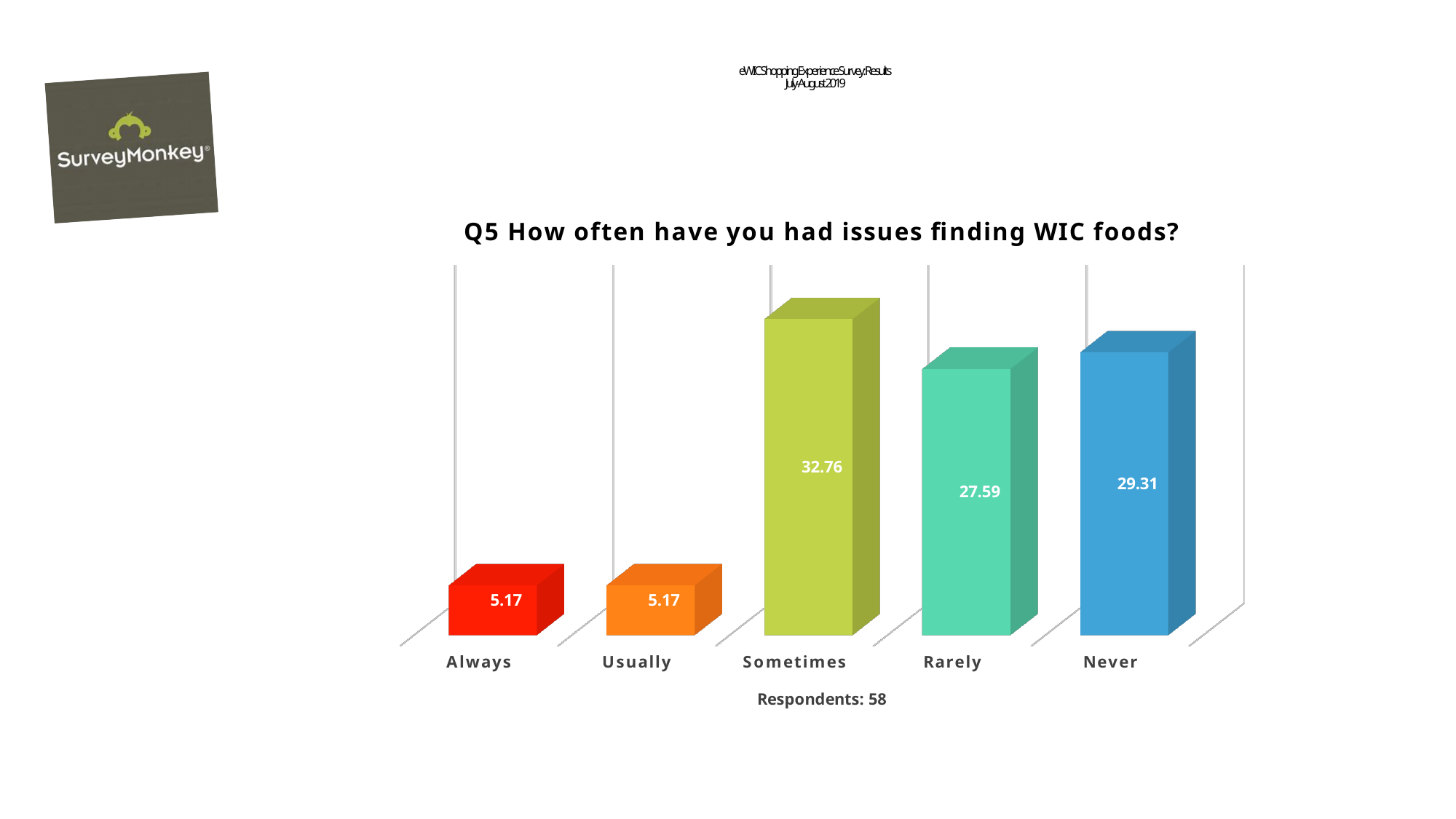
Which is larger, the value for Usually or the value for Sometimes? Sometimes What is the value for Rarely? 27.59 Which category has the highest value? Sometimes What is the value for Never? 29.31 Which is larger, the value for Rarely or the value for Never? Never What is the difference between the values for Sometimes and Never? 3.45 What is the value for Always? 5.17 What is the value for Sometimes? 32.76 What kind of chart is shown on the slide? Bar chart How many categories are shown on the chart? 5 What is the difference between the values for Never and Rarely? 1.72 What is the title of the chart? Q5 How often have you had issues finding WIC foods?